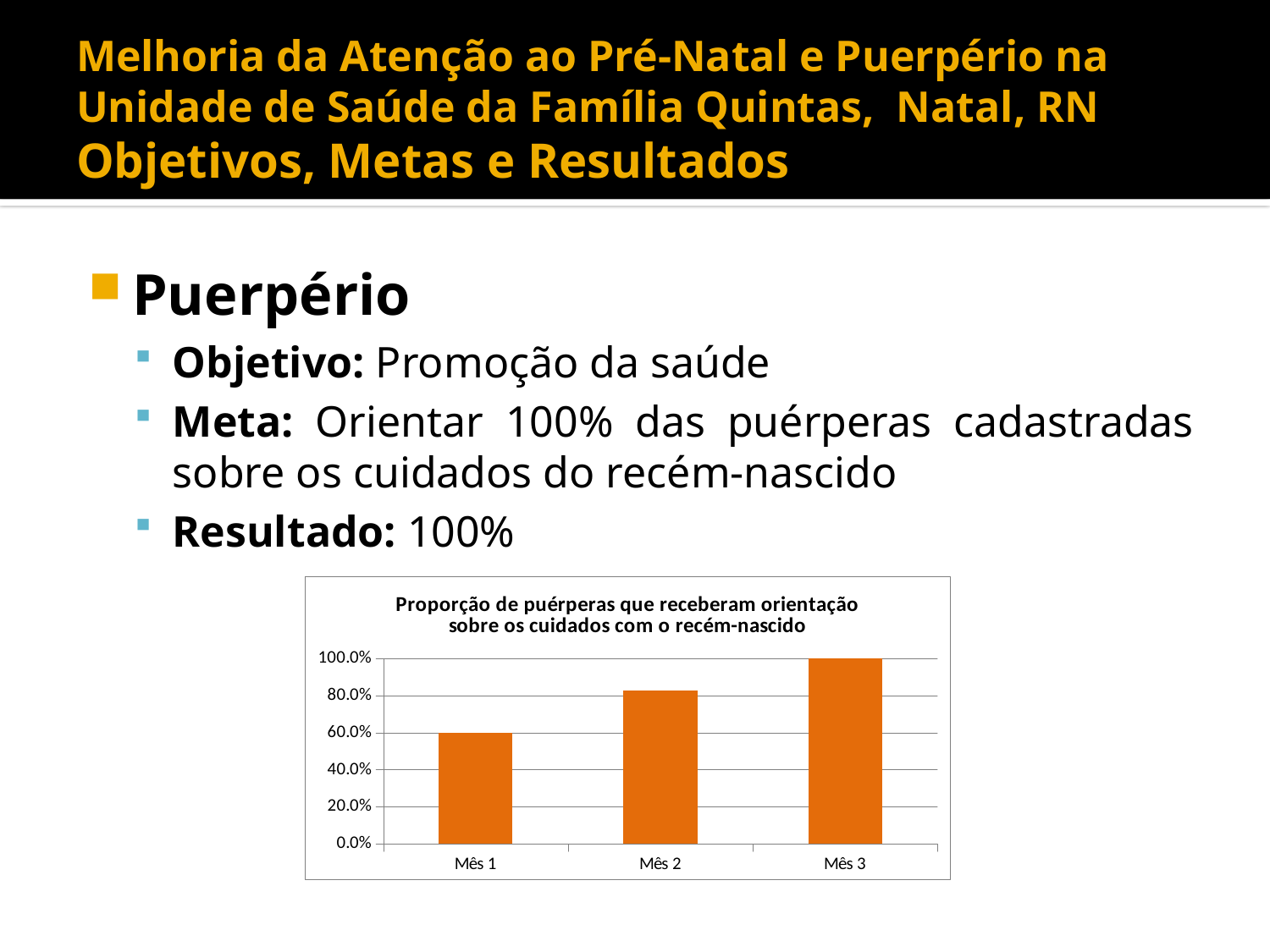
What colour are the bars in the chart? orange Which is larger, the value for Mês 2 or the value for Mês 1? Mês 2 Do the values rise or fall from Mês 1 to Mês 3? rise What is the title of the chart? Proporção de puérperas que receberam orientação sobre os cuidados com o recém-nascido Is the value for Mês 2 greater or less than 80.0%? greater What is the value for Mês 1 in the chart? 60.0% Is the value for Mês 2 greater or less than 100.0%? less Which month has the lowest value in the chart? Mês 1 Which month has the highest value in the chart? Mês 3 What is the value for Mês 3 in the chart? 100.0% How many categories (months) are plotted on the x axis of the chart? 3 What kind of chart is shown on the slide? bar chart